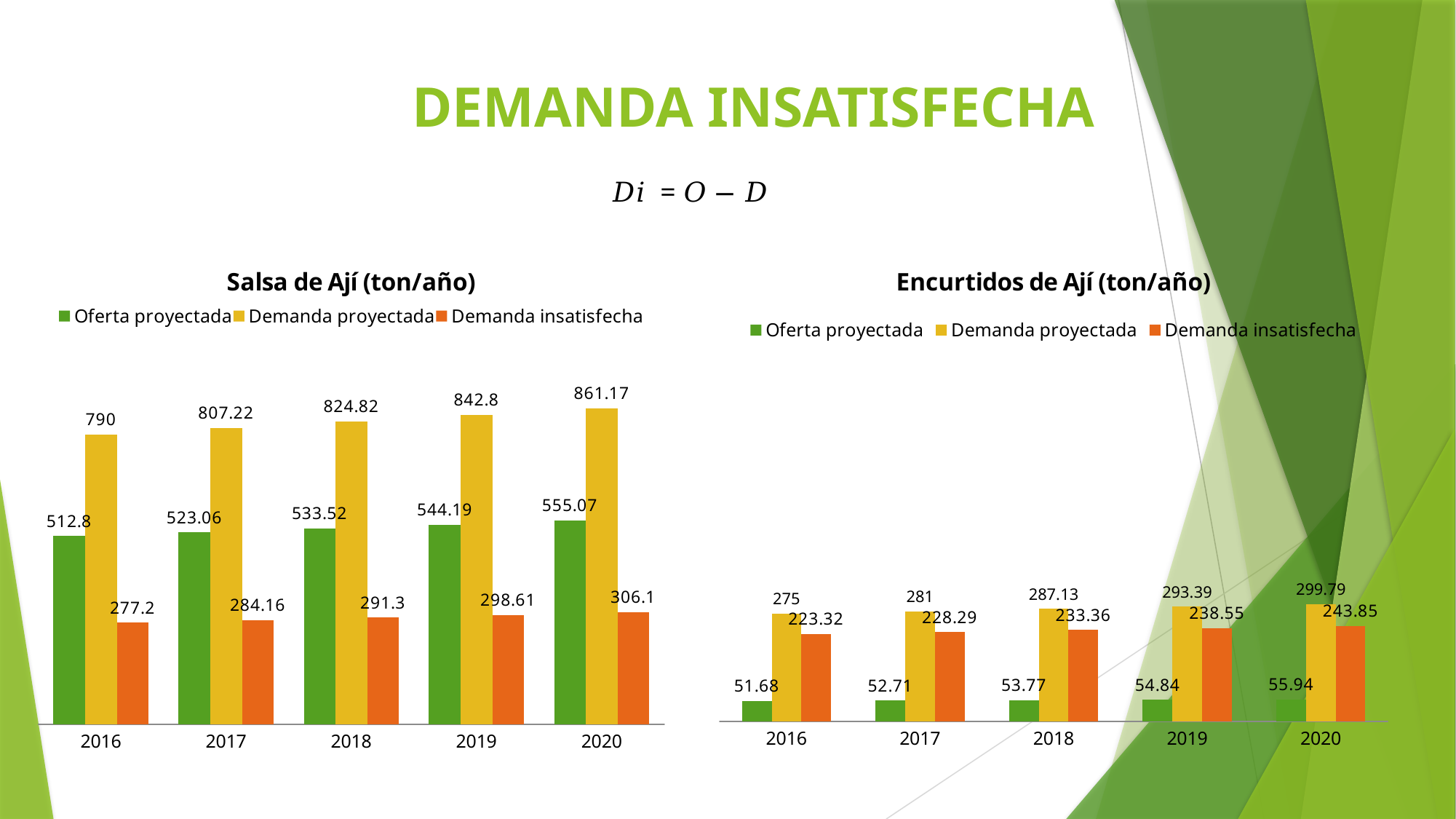
In the 'Salsa de Ají (ton/año)' chart, does Demanda insatisfecha rise or fall from 2016 to 2020? rise How many years are shown on the x axis of the 'Salsa de Ají (ton/año)' chart? 5 In the 'Encurtidos de Ají (ton/año)' chart, what is the value of Demanda insatisfecha for 2019? 238.55 In the 'Encurtidos de Ají (ton/año)' chart, what is the value of Oferta proyectada for 2020? 55.94 In the 'Salsa de Ají (ton/año)' chart, what is the value of Oferta proyectada for 2016? 512.8 In the 'Salsa de Ají (ton/año)' chart, what is the difference between Demanda proyectada and Oferta proyectada for 2020? 306.1 In the 'Encurtidos de Ají (ton/año)' chart, which year has the lowest Oferta proyectada? 2016 In the 'Salsa de Ají (ton/año)' chart, what is the value of Demanda proyectada for 2018? 824.82 In the 'Encurtidos de Ají (ton/año)' chart, what is the difference between Demanda proyectada for 2018 and Demanda proyectada for 2016? 12.13 How many series does the legend of the 'Encurtidos de Ají (ton/año)' chart list? 3 In the 'Salsa de Ají (ton/año)' chart, which year has the highest Demanda proyectada? 2020 In the 'Salsa de Ají (ton/año)' chart, which is larger: Oferta proyectada for 2019 or Demanda insatisfecha for 2019? Oferta proyectada for 2019